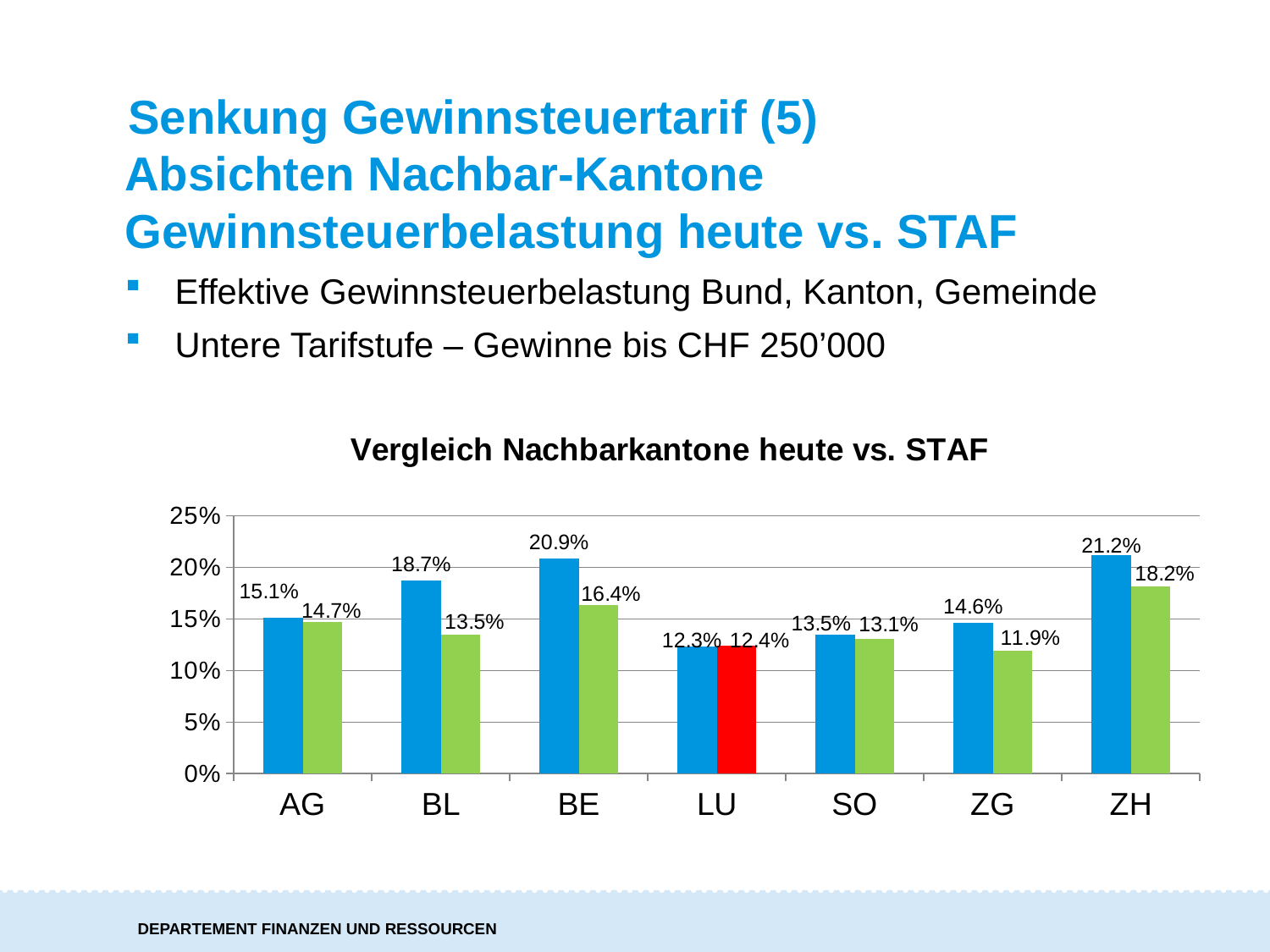
Which canton has the lowest second bar? ZG What is the difference between the first and second bar for BL? 5.2% Which canton has the highest first (blue) bar? ZH What is the title of the chart? Vergleich Nachbarkantone heute vs. STAF What kind of chart is shown on the slide? bar chart What is the difference between the first and second bar for ZH? 3.0% Which is larger: the first (blue) bar for AG or the first (blue) bar for ZG? AG What is the value of the first (blue) bar for BE? 20.9% What is the value of the red bar for LU? 12.4% How many cantons are shown on the x axis? 7 Is the second (green) bar for SO greater or less than 15%? less What is the value of the second (green) bar for ZG? 11.9%